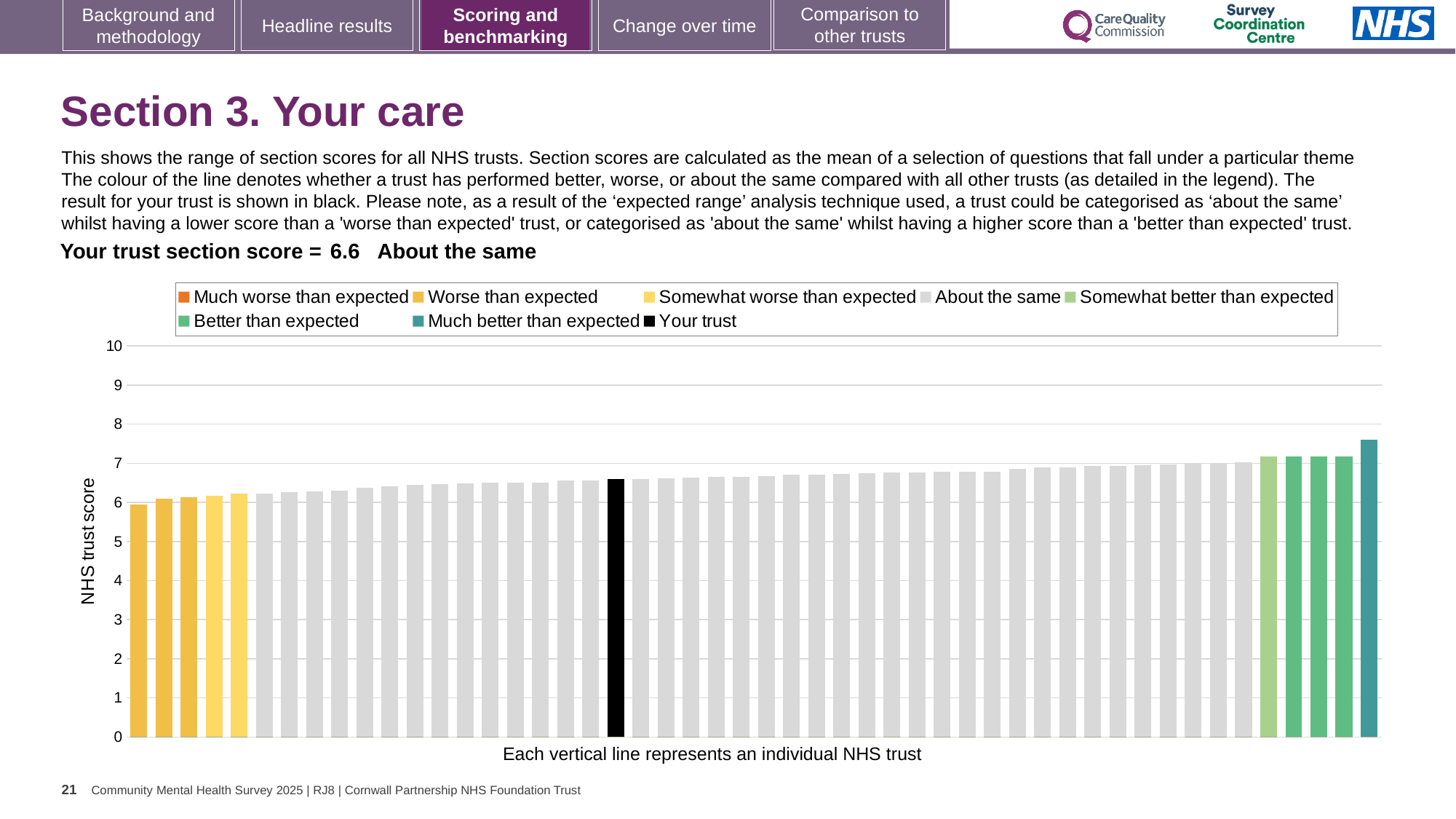
Which legend category does the tallest bar belong to? Much better than expected Do the bar values rise or fall from left to right along the x axis? rise Is the value of the tallest bar greater or less than 8? less What kind of chart is shown on the slide? bar chart How many entries does the chart legend list? 8 What is the section score for your trust shown on the slide? 6.6 What is the title of the vertical axis? NHS trust score Which category is your trust placed in for this section? About the same Is the value for your trust (the black bar) greater or less than 5? greater Is the value of the shortest bar greater or less than 5? greater What colour is the bar representing your trust? black